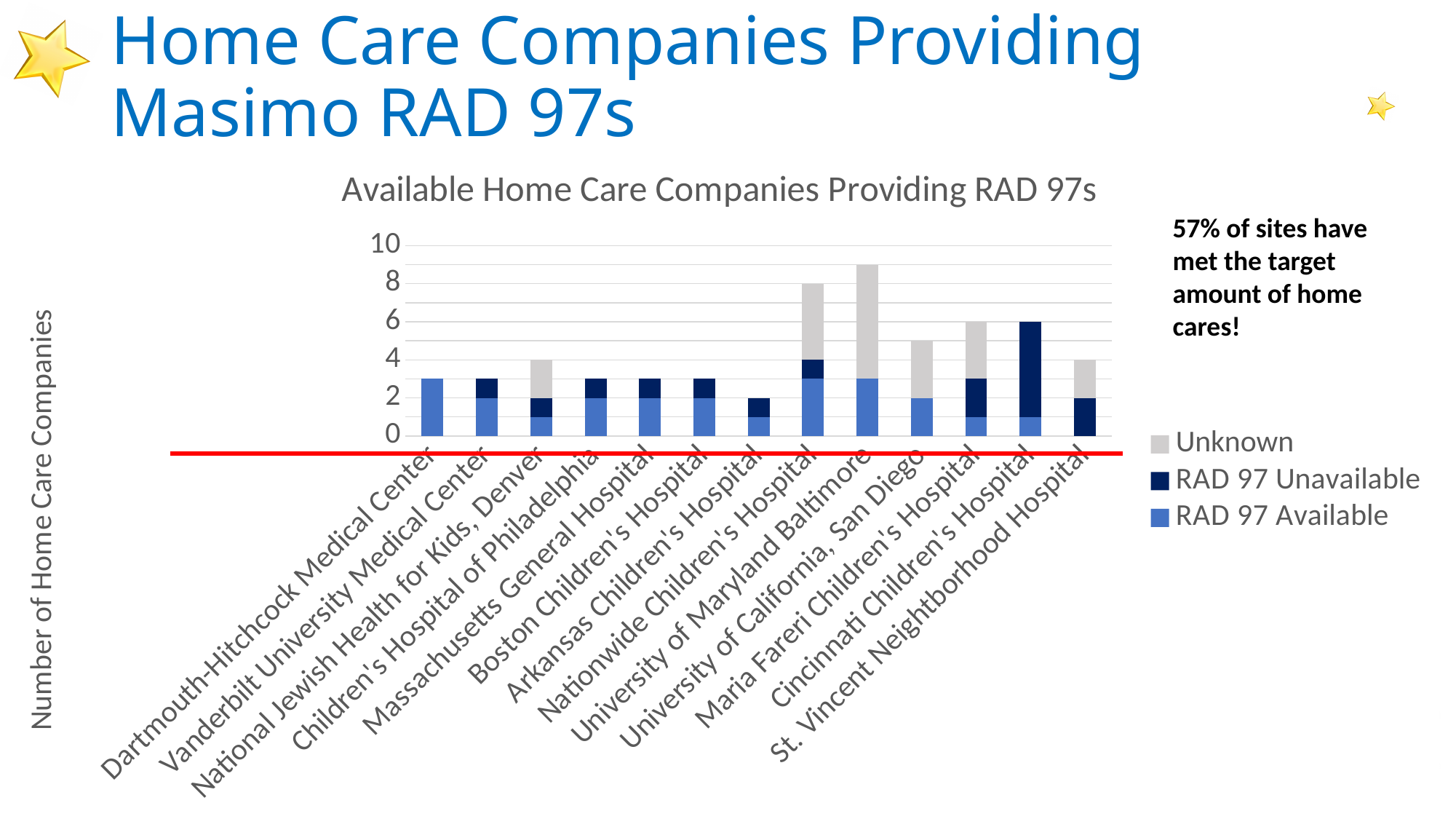
What is the title of the chart? Available Home Care Companies Providing RAD 97s Is the total bar height for Dartmouth-Hitchcock Medical Center greater or less than 4? less Is the total bar height for University of Maryland Baltimore greater or less than 8? greater Which has a taller stacked bar: Nationwide Children's Hospital or University of California, San Diego? Nationwide Children's Hospital Which hospital has the tallest stacked bar (highest total number of home care companies)? University of Maryland Baltimore How many hospitals (categories) are shown on the x axis of the chart? 13 What is the total height of the stacked bar for St. Vincent Neightborhood Hospital? 4 How many series does the chart legend list? 3 What is the total height of the stacked bar for Cincinnati Children's Hospital? 6 What kind of chart is shown on the slide? Stacked bar chart What is the total height of the stacked bar for Nationwide Children's Hospital? 8 Which hospital has the shortest stacked bar (lowest total number of home care companies)? Arkansas Children's Hospital